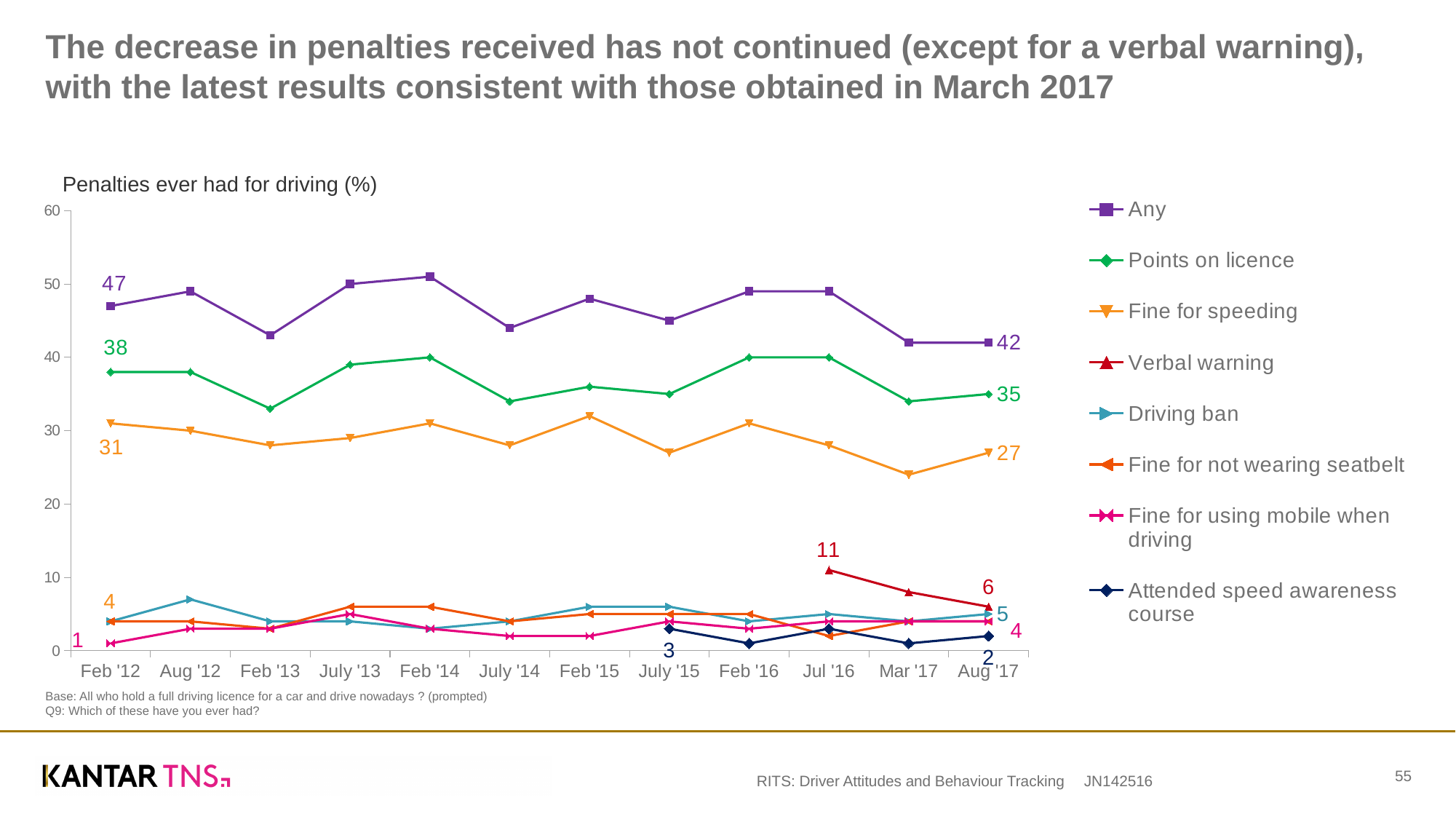
What is the value for 'Any' in Feb '12? 47 What is the value for 'Any' in Aug '17? 42 What is the value for 'Verbal warning' in Jul '16? 11 What is the value for 'Fine for speeding' in Feb '12? 31 What kind of chart is shown on the slide? line chart In Aug '17, which is larger: 'Points on licence' or 'Fine for speeding'? Points on licence Is the value for 'Fine for speeding' in Mar '17 greater or less than 30? less By how much did the value for 'Any' fall between Feb '12 and Aug '17? 5 How many series does the legend list? 8 Which series has the highest value in Aug '17? Any How many time points are shown along the x axis? 12 What is the value for 'Points on licence' in Aug '17? 35